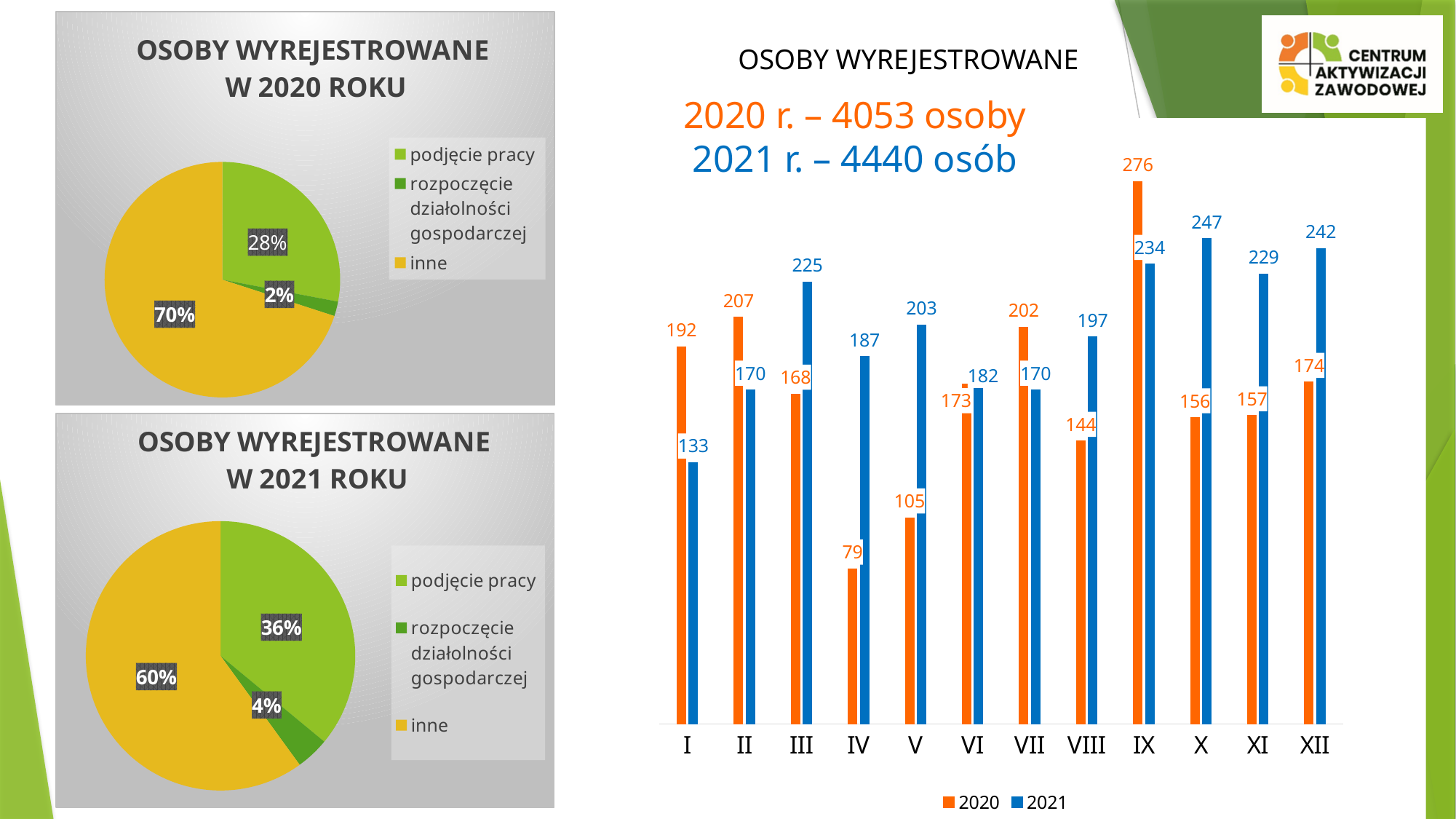
In the pie chart 'OSOBY WYREJESTROWANE W 2020 ROKU', which category has the smallest slice? rozpoczęcie działalności gospodarczej In the pie chart 'OSOBY WYREJESTROWANE W 2020 ROKU', which category has the largest slice? inne In the pie chart 'OSOBY WYREJESTROWANE W 2021 ROKU', what share is 'rozpoczęcie działalności gospodarczej'? 4% In the pie chart 'OSOBY WYREJESTROWANE W 2021 ROKU', what share is 'inne'? 60% In the bar chart 'OSOBY WYREJESTROWANE' on the right, which month has the lowest value for 2020? IV In the bar chart 'OSOBY WYREJESTROWANE' on the right, what is the value for 2021 in month IV? 187 In the bar chart 'OSOBY WYREJESTROWANE' on the right, how many series does the legend list? 2 In the bar chart 'OSOBY WYREJESTROWANE' on the right, which month has the highest value for 2021? X In the bar chart 'OSOBY WYREJESTROWANE' on the right, what is the difference between the 2021 and 2020 values in month XII? 68 In the bar chart 'OSOBY WYREJESTROWANE' on the right, what is the value for 2020 in month IX? 276 In the pie chart 'OSOBY WYREJESTROWANE W 2020 ROKU', what share is 'podjęcie pracy'? 28% In the bar chart 'OSOBY WYREJESTROWANE' on the right, which is larger in month I: the 2020 value or the 2021 value? 2020